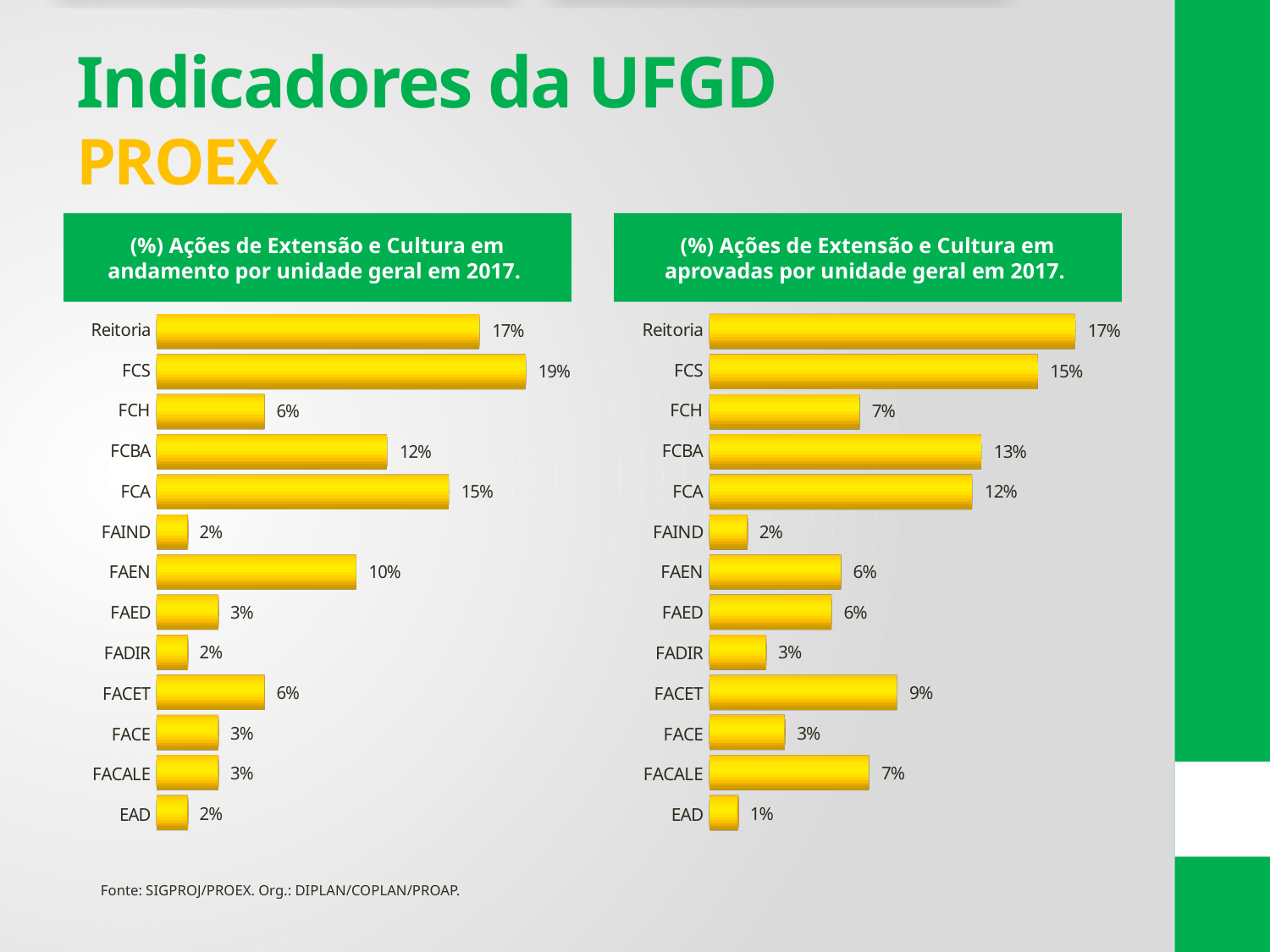
In the right chart (Ações aprovadas), which unit has the highest value? Reitoria What is the title of the left chart? (%) Ações de Extensão e Cultura em andamento por unidade geral em 2017. In the right chart (Ações aprovadas), what is the value for FACET? 9% In the left chart (Ações em andamento), what is the difference between the values for FCS and FCA? 4% How many units are shown in the left chart (Ações em andamento)? 13 What type of chart is the right chart (Ações aprovadas)? Bar chart In the right chart (Ações aprovadas), what is the value for FACALE? 7% In the left chart (Ações em andamento), what is the value for FCS? 19% In the left chart (Ações em andamento), what is the value for FAEN? 10% In the right chart (Ações aprovadas), which unit has the lowest value? EAD In the left chart (Ações em andamento), which unit has the highest value? FCS In the right chart (Ações aprovadas), which is larger, the value for FCBA or the value for FCA? FCBA